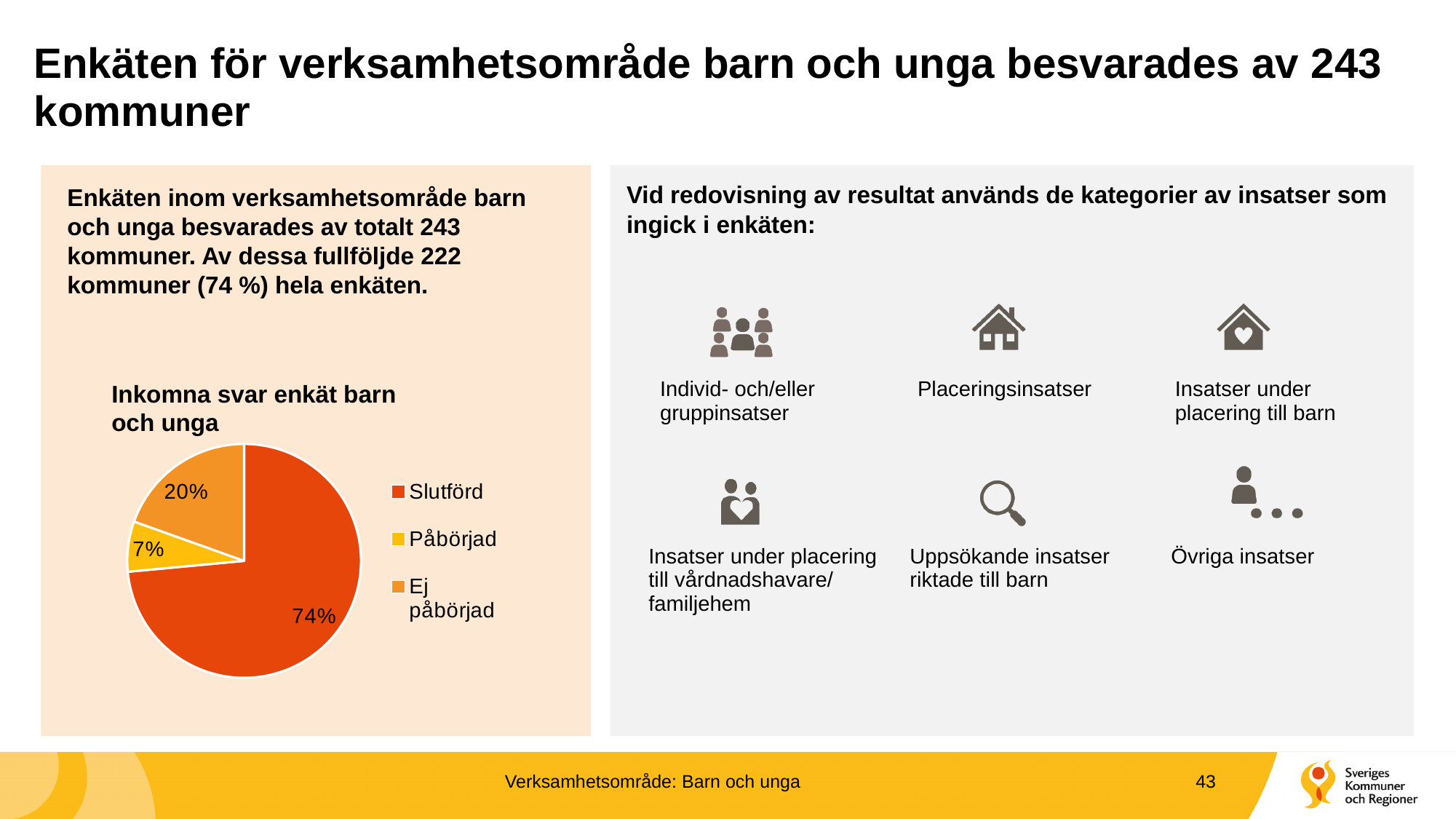
What share of the pie is Påbörjad? 7% Which category has the smallest share of the pie? Påbörjad Which is larger, the share for Ej påbörjad or the share for Påbörjad? Ej påbörjad How many slices does the pie chart have? 3 What share of the pie is Slutförd? 74% How many entries does the legend list? 3 What is the title of the chart? Inkomna svar enkät barn och unga What colour is the Slutförd slice? red-orange Which category has the largest share of the pie? Slutförd What is the difference in percentage points between Slutförd and Ej påbörjad? 54 What kind of chart is shown on the slide? pie chart What share of the pie is Ej påbörjad? 20%